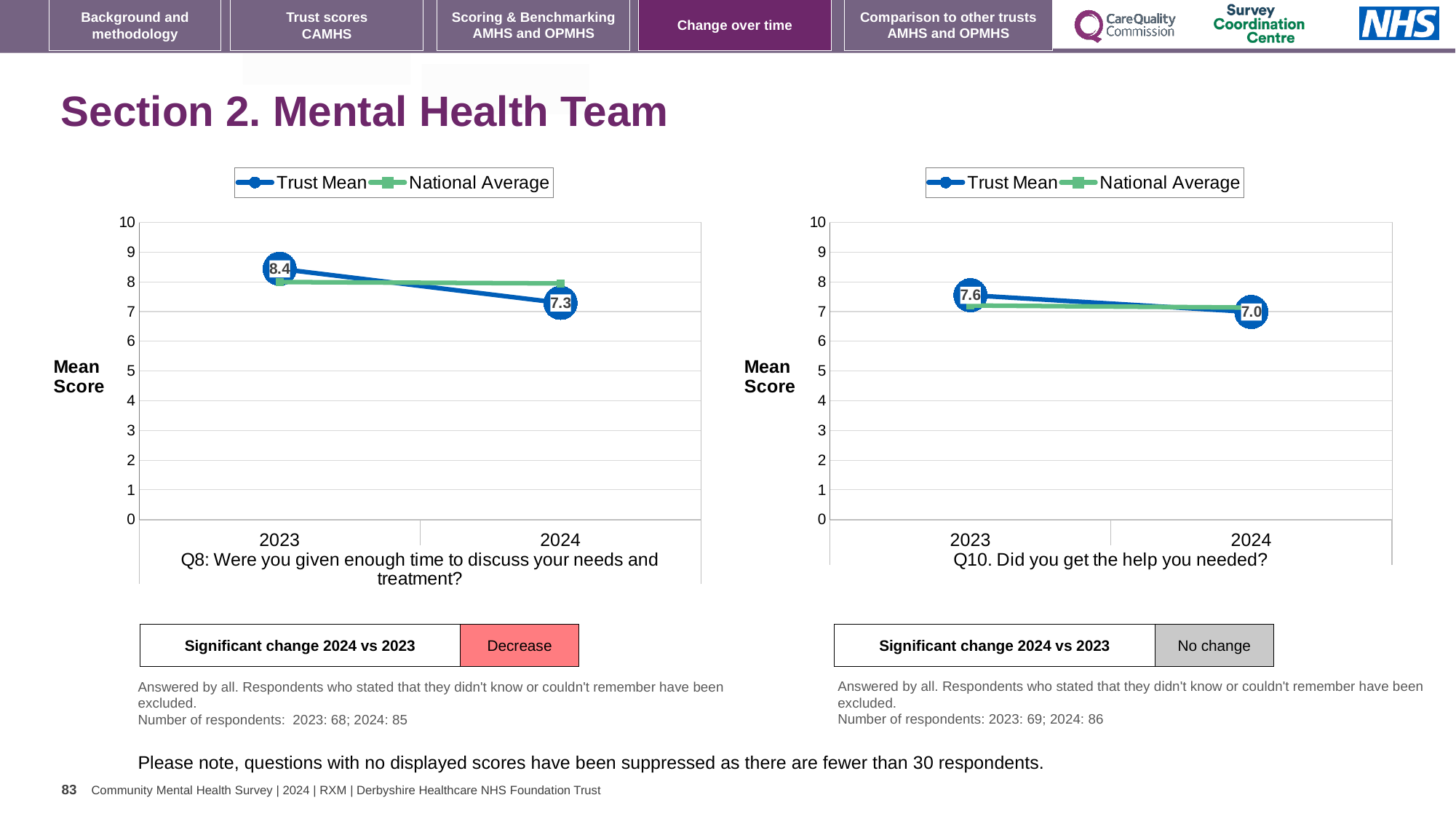
In the right chart (Q10), what is the difference between the Trust Mean scores for 2023 and 2024? 0.6 In the right chart (Q10. Did you get the help you needed?), what is the Trust Mean score for 2023? 7.6 In the right chart (Q10), what is the Trust Mean score for 2024? 7.0 In the right chart (Q10), does the Trust Mean rise or fall from 2023 to 2024? fall In the left chart (Q8: Were you given enough time to discuss your needs and treatment?), what is the Trust Mean score for 2023? 8.4 In the left chart (Q8), what is the Trust Mean score for 2024? 7.3 In the left chart (Q8), does the Trust Mean rise or fall from 2023 to 2024? fall In the left chart (Q8), by how much did the Trust Mean score change from 2023 to 2024? 1.1 In the left chart (Q8), is the Trust Mean or the National Average higher in 2023? Trust Mean What type of chart is the left chart (Q8)? line chart How many series does the legend of the right chart (Q10) list? 2 In the left chart (Q8), is the National Average value for 2023 greater or less than 7? greater